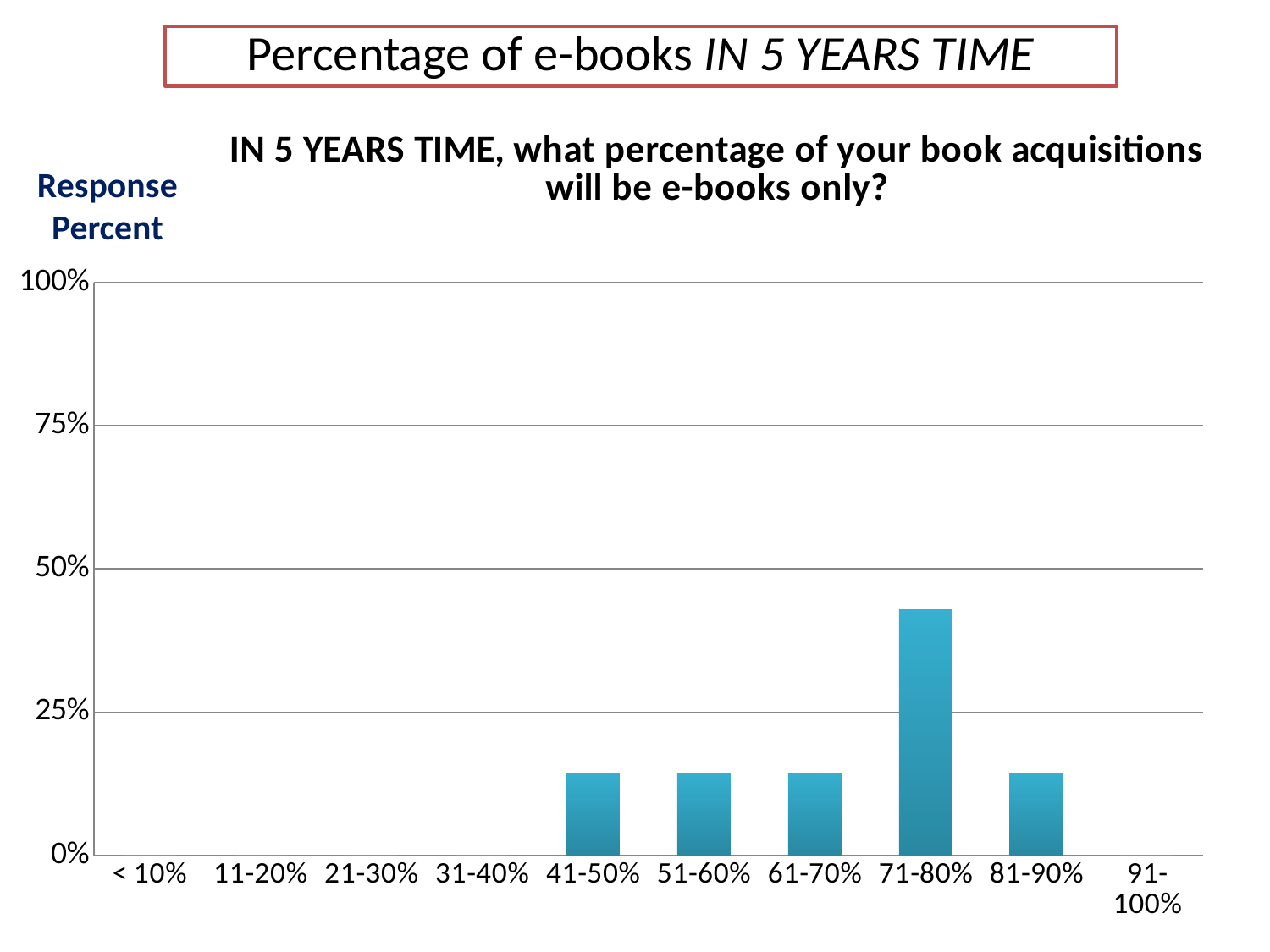
Is the value for 71-80% greater or less than 50%? less What kind of chart is shown on the slide? bar chart How many categories are shown on the x axis of the chart? 10 Is the value for 81-90% greater or less than 25%? less Which category has the highest response percent? 71-80% How many categories have a response percent of 0%? 5 What is the question shown as the chart title? IN 5 YEARS TIME, what percentage of your book acquisitions will be e-books only? What is the label of the vertical axis? Response Percent Is the value for 41-50% greater or less than 25%? less Which is larger, the value for 71-80% or the value for 81-90%? 71-80% Which is larger, the value for 61-70% or the value for 71-80%? 71-80%